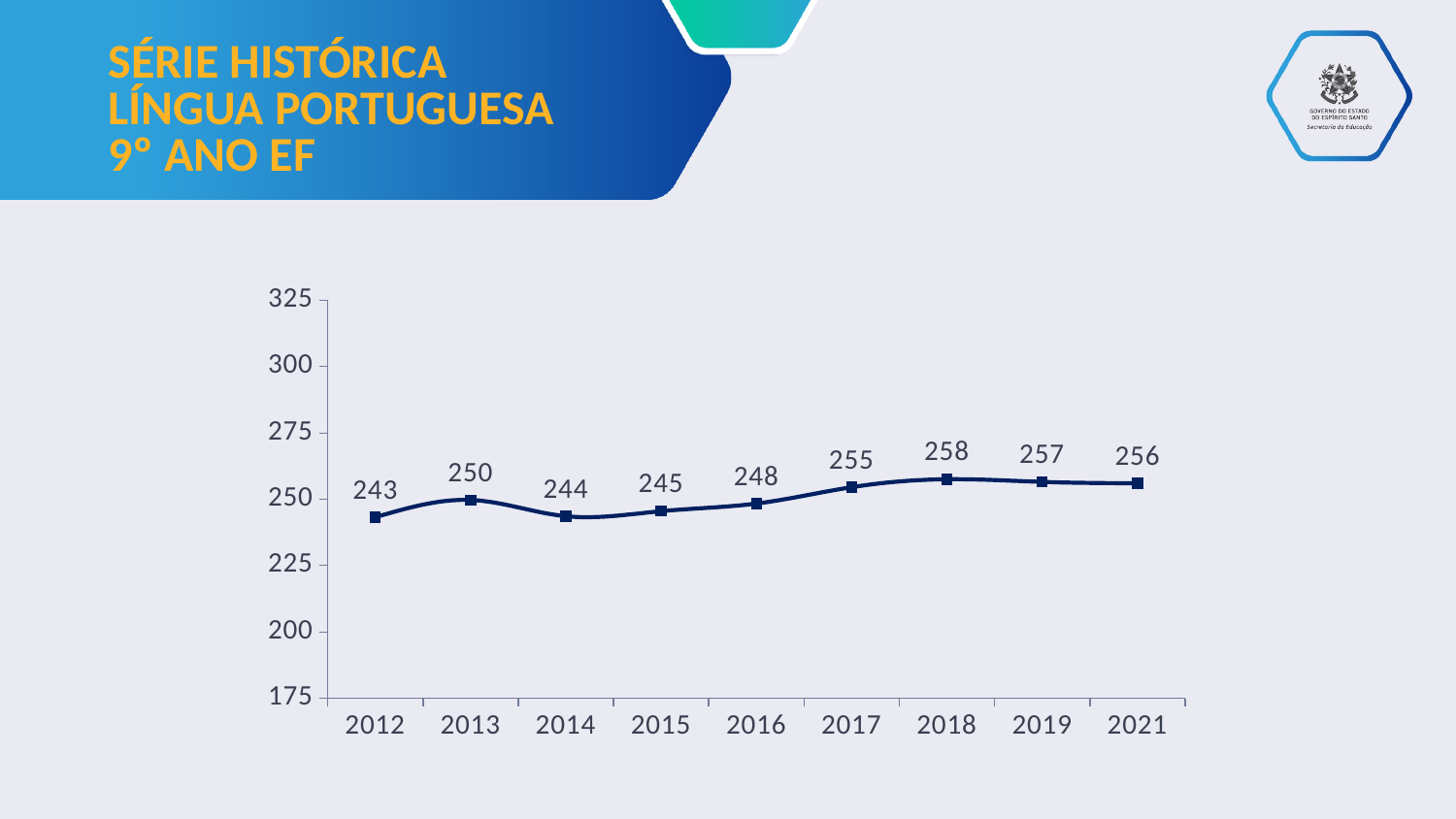
What is the value for 2018? 258 Which year has the highest value? 2018 Is the value for 2017 greater or less than 250? greater What is the title of the slide? SÉRIE HISTÓRICA LÍNGUA PORTUGUESA 9º ANO EF Which year has the lowest value? 2012 What is the value for 2021? 256 What is the value for 2012? 243 How many years are plotted on the chart? 9 Which is larger, the value for 2013 or the value for 2014? 2013 Do the values generally rise or fall from 2014 to 2018? rise What kind of chart is shown on the slide? line chart What is the difference between the values for 2018 and 2012? 15